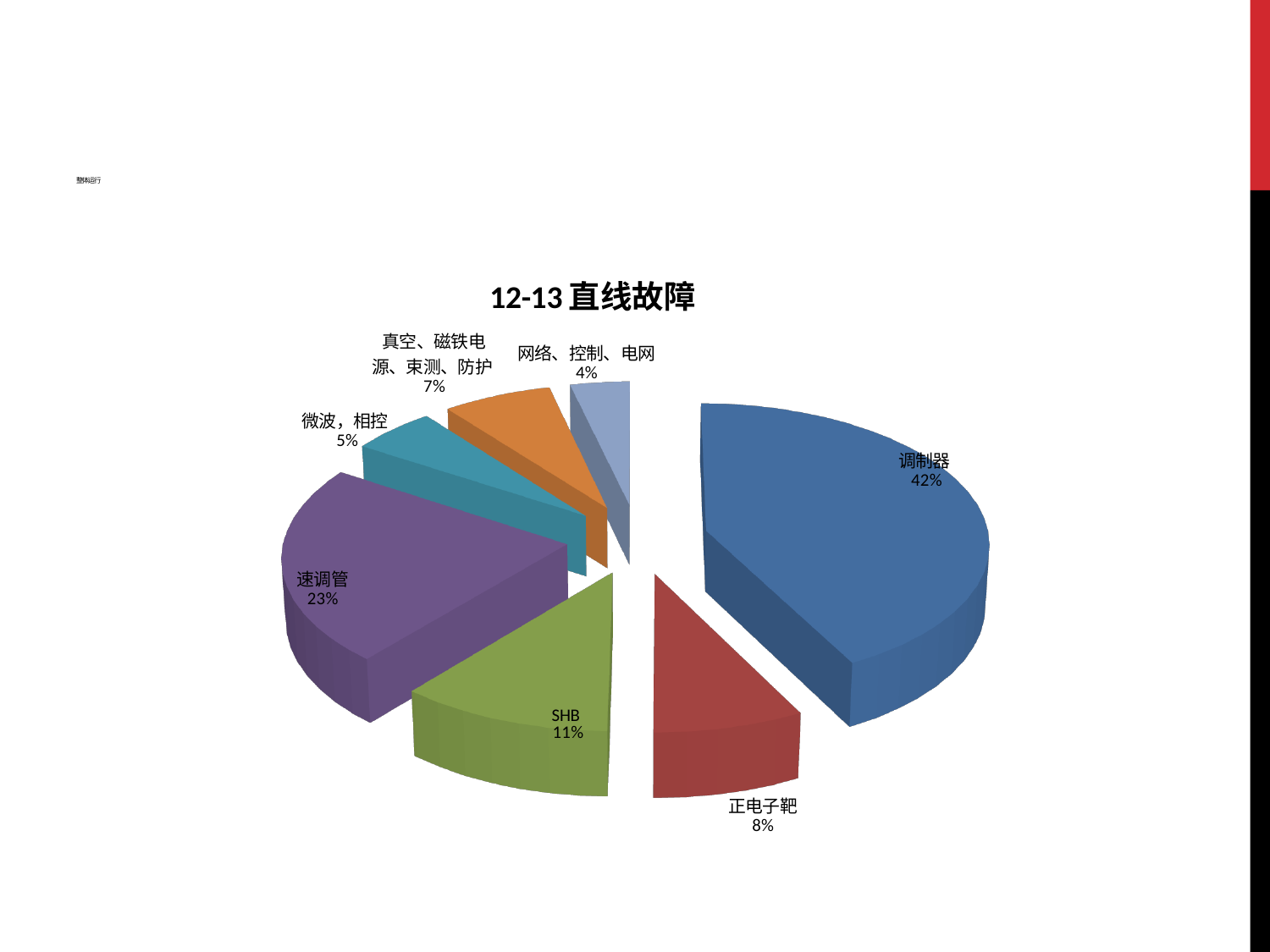
What kind of chart is shown on the slide? pie chart What is the title of the chart? 12-13 直线故障 What share of the pie does 调制器 account for? 42% What is the difference between the shares of 调制器 and 速调管? 19% How many slices does the pie chart have? 7 Which category has the largest share of the pie? 调制器 Which is larger, the share for SHB or the share for 正电子靶? SHB What is the value shown for 正电子靶? 8% What is the value shown for 微波，相控? 5% Which category has the smallest share of the pie? 网络、控制、电网 What is the value shown for SHB? 11% What share of the pie does 速调管 account for? 23%